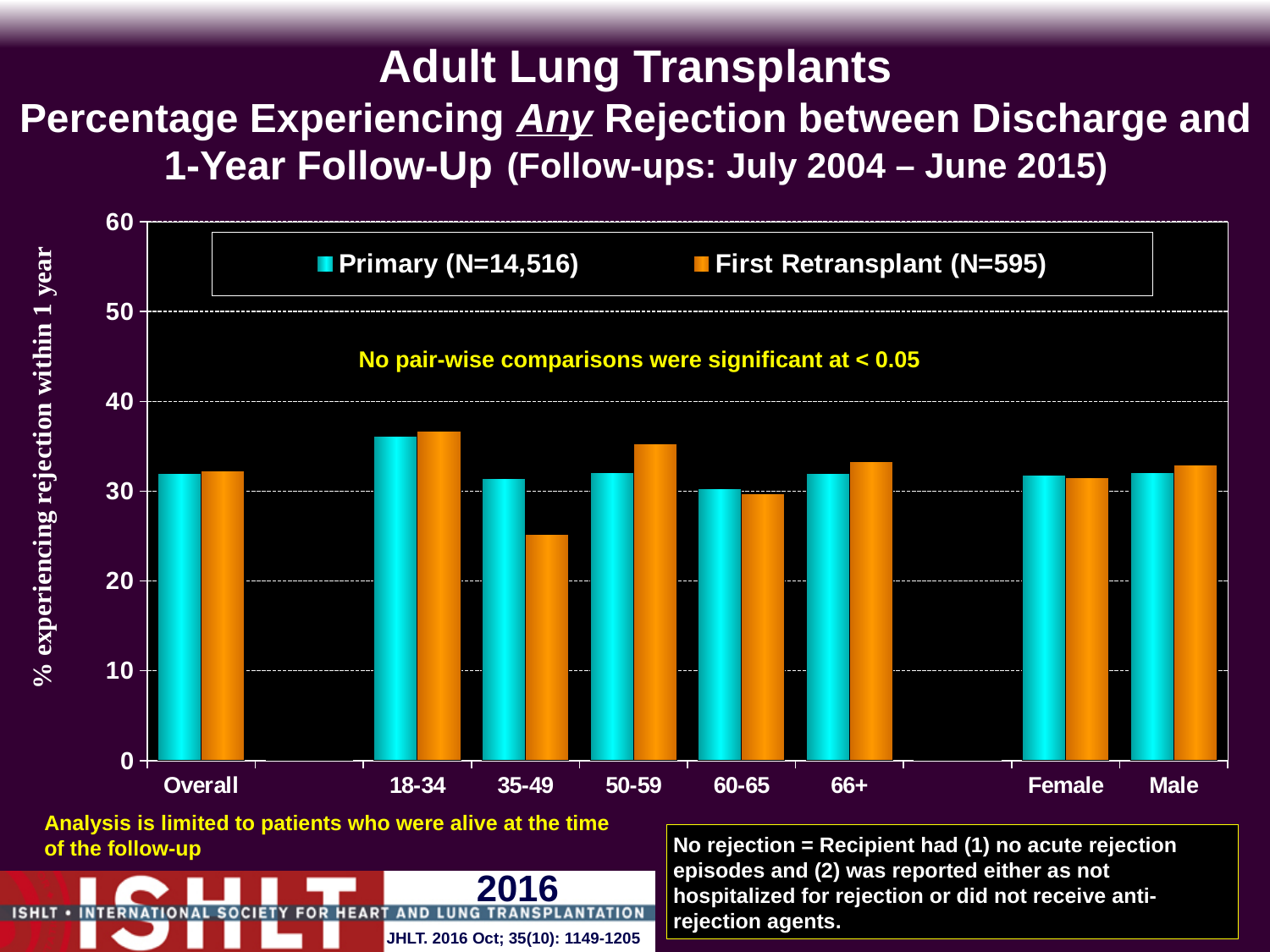
What kind of chart is shown on the slide? bar chart Is the Primary value for 18-34 greater or less than 30? greater For the 35-49 group, which is larger: the Primary value or the First Retransplant value? Primary Which category has the lowest value for First Retransplant (N=595)? 35-49 How many categories are shown along the x axis? 8 Which category has the highest value for Primary (N=14,516)? 18-34 Is the First Retransplant value for 50-59 greater or less than 40? less Is the First Retransplant value for 35-49 greater or less than 30? less What is the sample size (N) given in the legend for the Primary series? 14,516 For the 50-59 group, which is larger: the Primary value or the First Retransplant value? First Retransplant What is the y-axis label of the chart? % experiencing rejection within 1 year How many series does the legend list? 2